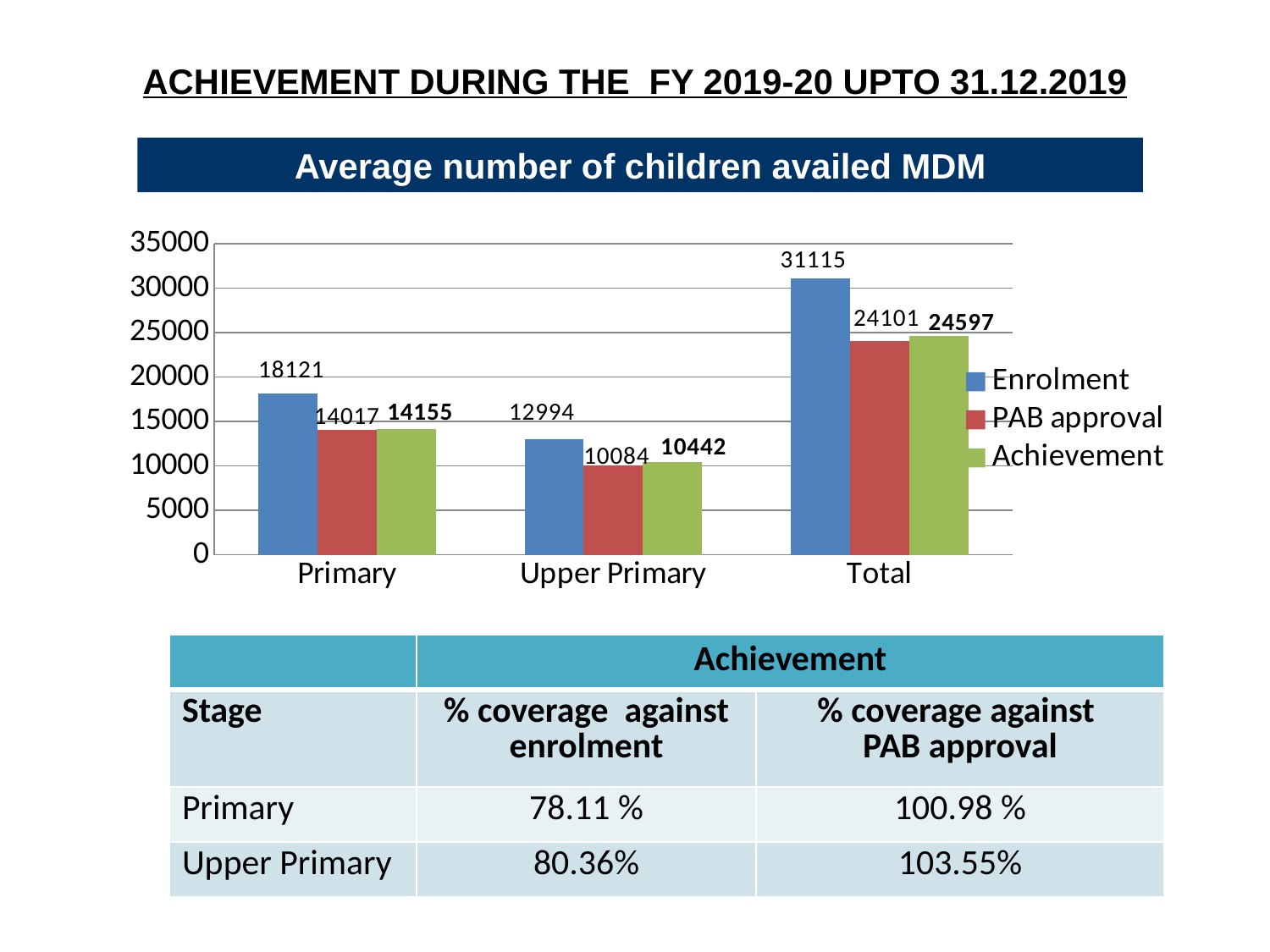
What is the Enrolment value for Primary? 18121 Which category has the lowest PAB approval value? Upper Primary Which is larger for Upper Primary, Enrolment or PAB approval? Enrolment What is the difference between Enrolment and Achievement for Primary? 3966 Is the Enrolment value for Total greater or less than 30000? greater What is the title of the chart? Average number of children availed MDM How many categories are shown on the x axis? 3 Which category has the highest Enrolment value? Total What is the PAB approval value for Total? 24101 What kind of chart is shown? bar chart What is the Achievement value for Upper Primary? 10442 How many series does the legend list? 3